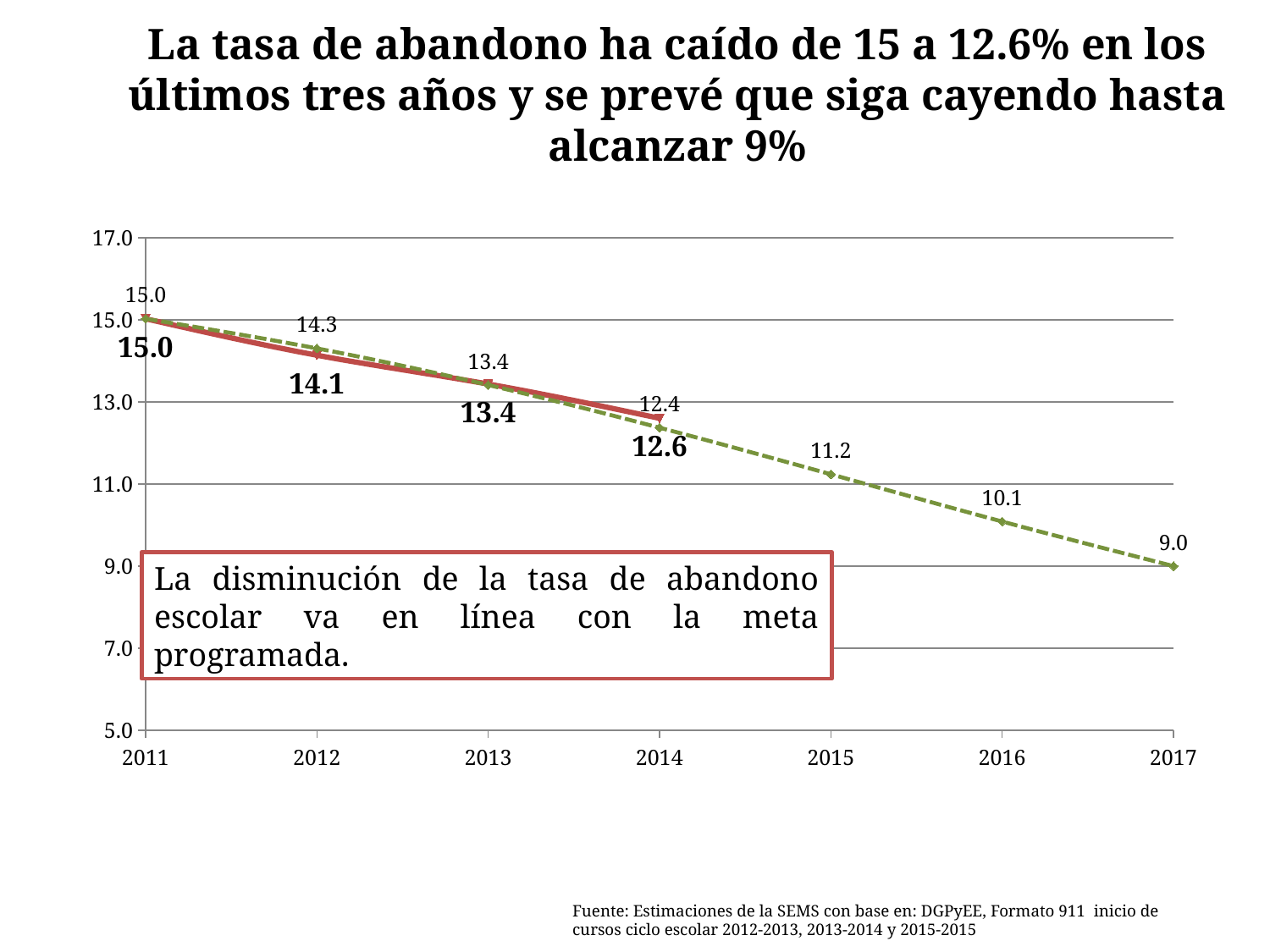
What is the value of the dashed green line in 2015? 11.2 In which year does the dashed green line reach its lowest value? 2017 What is the value of the dashed green line in 2016? 10.1 What is the difference between the solid red line and the dashed green line in 2014? 0.2 Do the values of the dashed green line rise or fall from 2011 to 2017? fall What is the value of the solid red line in 2014? 12.6 What is the value of the dashed green line in 2017? 9.0 What kind of chart is shown on the slide? line chart In 2012, which is larger: the solid red line or the dashed green line? the dashed green line What is the difference between the dashed green line's values in 2011 and 2017? 6.0 What is the value of the solid red line in 2012? 14.1 How many years are shown on the x axis? 7